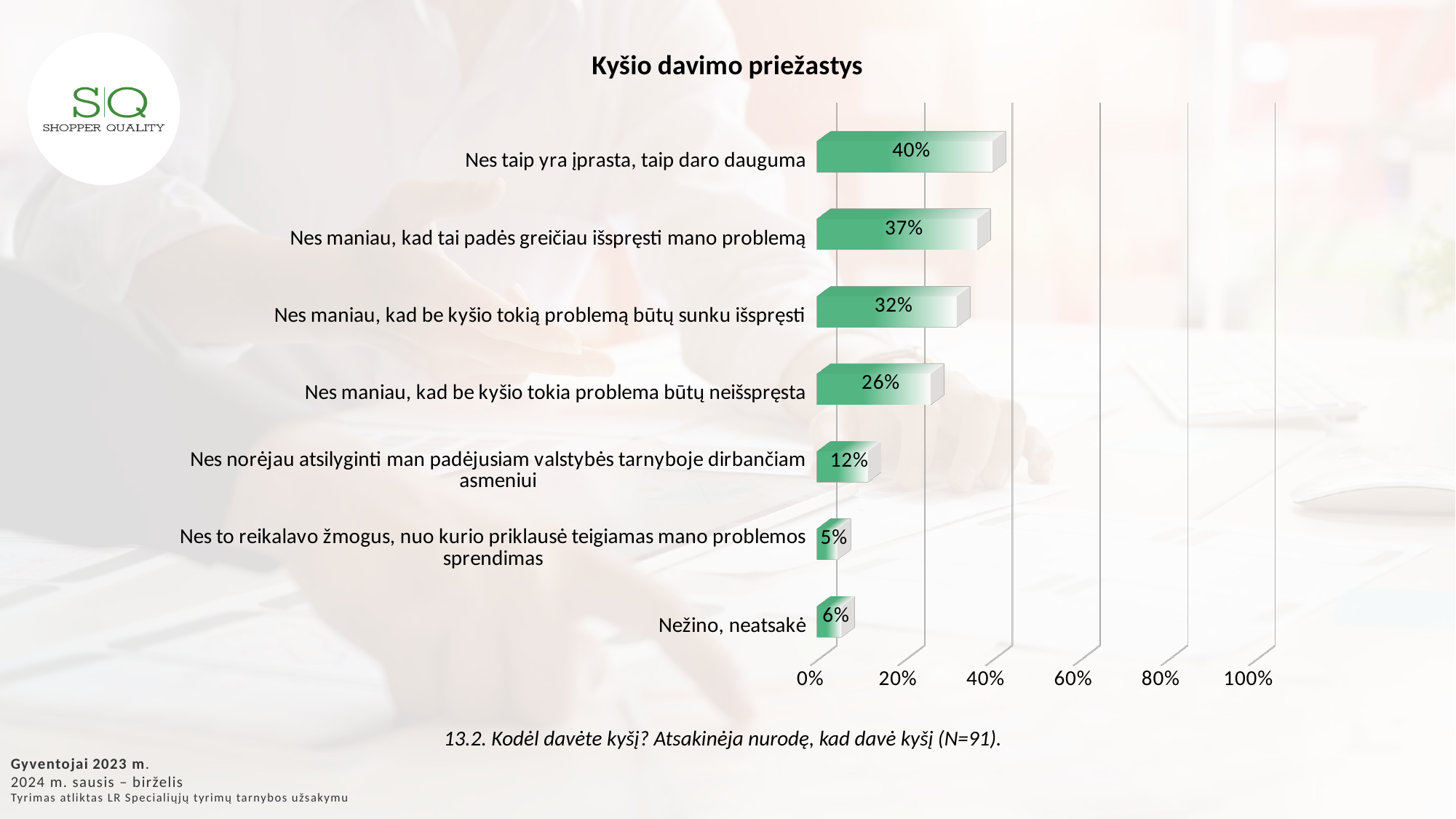
What is the title of the chart? Kyšio davimo priežastys Which is larger: the value for "Nes maniau, kad be kyšio tokią problemą būtų sunku išspręsti" or the value for "Nes maniau, kad be kyšio tokia problema būtų neišspręsta"? Nes maniau, kad be kyšio tokią problemą būtų sunku išspręsti Which category has the lowest value? Nes to reikalavo žmogus, nuo kurio priklausė teigiamas mano problemos sprendimas Is the value for "Nes norėjau atsilyginti man padėjusiam valstybės tarnyboje dirbančiam asmeniui" greater or less than 20%? less How many categories are shown in the chart? 7 What is the value for "Nes maniau, kad be kyšio tokia problema būtų neišspręsta"? 26% What is the value for "Nežino, neatsakė"? 6% Which category has the highest value? Nes taip yra įprasta, taip daro dauguma What is the difference between the values for "Nes maniau, kad be kyšio tokią problemą būtų sunku išspręsti" and "Nes norėjau atsilyginti man padėjusiam valstybės tarnyboje dirbančiam asmeniui"? 20% What is the difference between the values for "Nes taip yra įprasta, taip daro dauguma" and "Nes maniau, kad tai padės greičiau išspręsti mano problemą"? 3% What kind of chart is shown on the slide? bar chart What is the value for "Nes taip yra įprasta, taip daro dauguma"? 40%